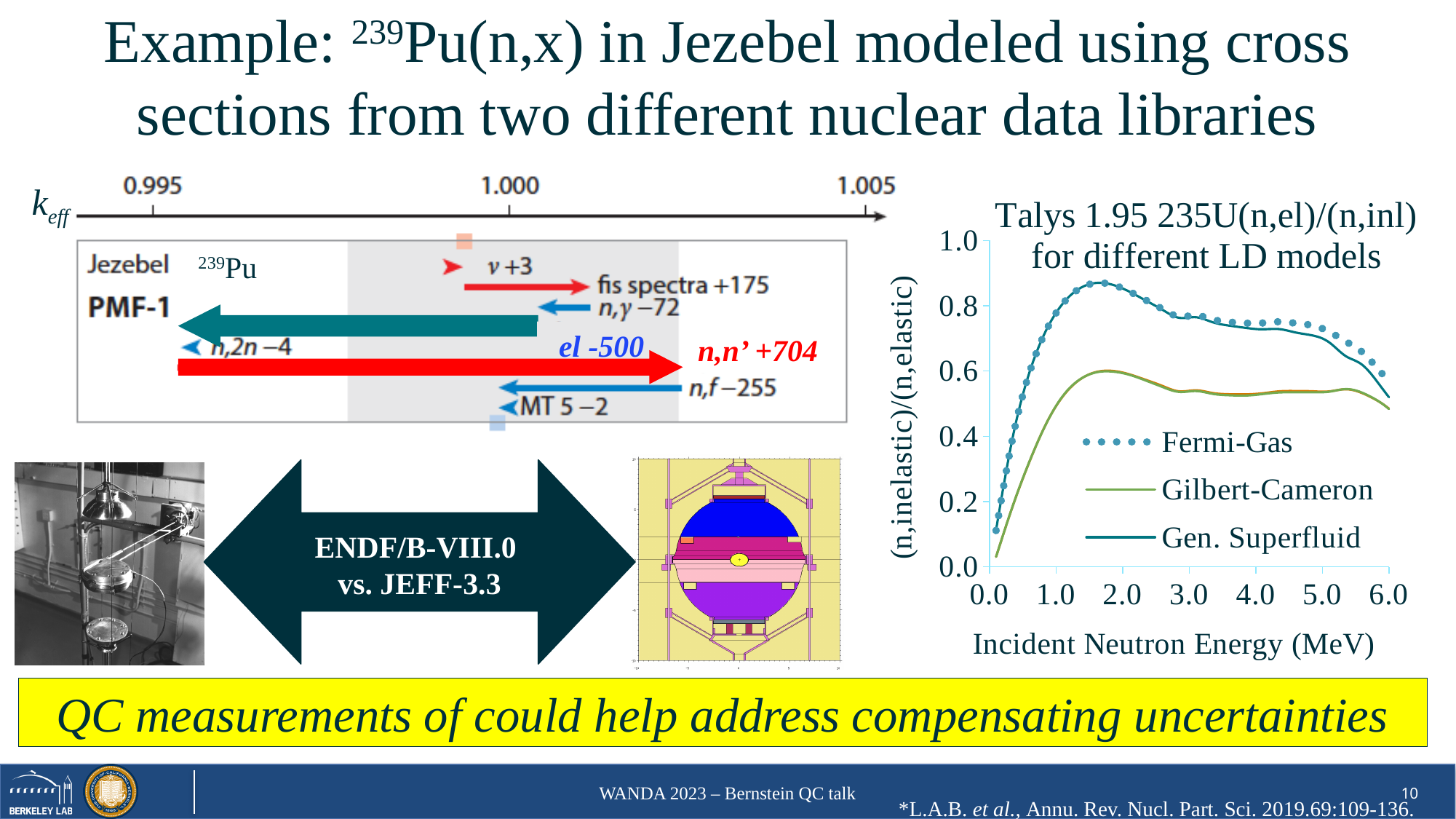
In the Talys 1.95 chart on the right, which series is lowest at 3.0 MeV? Gilbert-Cameron In the k_eff sensitivity diagram on the left, what value is printed for el? -500 How many series does the legend of the Talys 1.95 chart on the right list? 3 In the Talys 1.95 chart on the right, which is larger at 3.0 MeV: Fermi-Gas or Gilbert-Cameron? Fermi-Gas In the Talys 1.95 chart on the right, is the Fermi-Gas value at 2.0 MeV greater or less than 0.8? greater What is the x-axis label of the Talys 1.95 chart on the right? Incident Neutron Energy (MeV) In the k_eff sensitivity diagram on the left, what value is printed for n,n'? +704 In the Talys 1.95 chart on the right, does the Fermi-Gas series rise or fall between 2.0 and 6.0 MeV? fall In the Talys 1.95 chart on the right, is the Gilbert-Cameron value at 2.0 MeV greater or less than 0.8? less In the Talys 1.95 chart on the right, is the Gilbert-Cameron value at 4.0 MeV greater or less than 0.4? greater What are the three series named in the legend of the Talys 1.95 chart on the right? Fermi-Gas, Gilbert-Cameron, Gen. Superfluid What kind of chart is the Talys 1.95 235U(n,el)/(n,inl) chart on the right of the slide? line chart